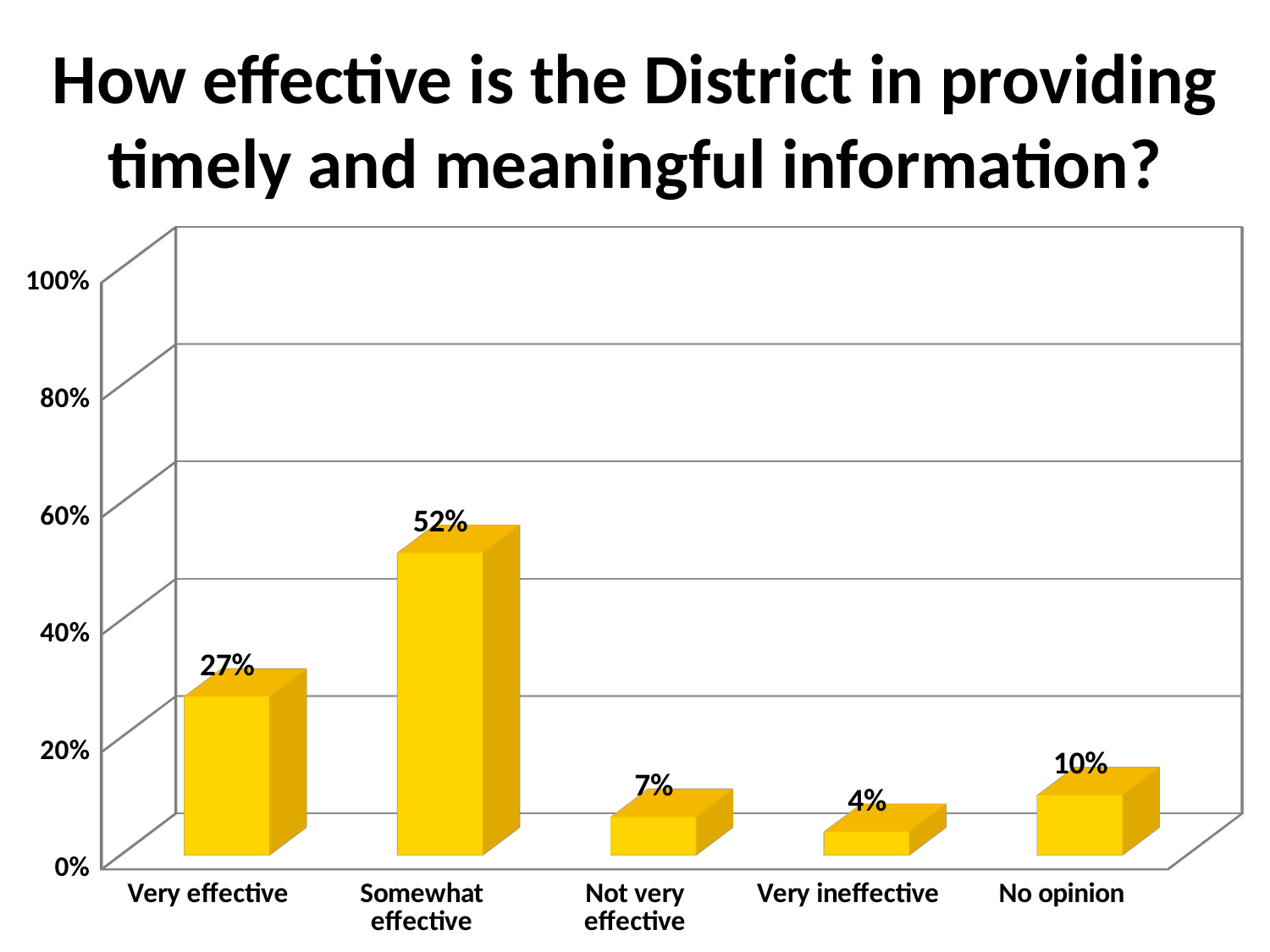
What is the difference between 'No opinion' and 'Very ineffective'? 6% What type of chart is shown on the slide? Bar chart What percentage of respondents chose 'Not very effective'? 7% Which is larger, the value for 'Not very effective' or the value for 'No opinion'? No opinion Which response category has the highest percentage? Somewhat effective What is the difference in percentage points between 'Somewhat effective' and 'Very effective'? 25 What is the value shown for 'Somewhat effective'? 52% What is the value for 'No opinion'? 10% Which response category has the lowest percentage? Very ineffective How many response categories are shown on the chart? 5 Is the value for 'Somewhat effective' greater or less than 40%? greater What percentage of respondents said the District is very effective in providing timely and meaningful information? 27%